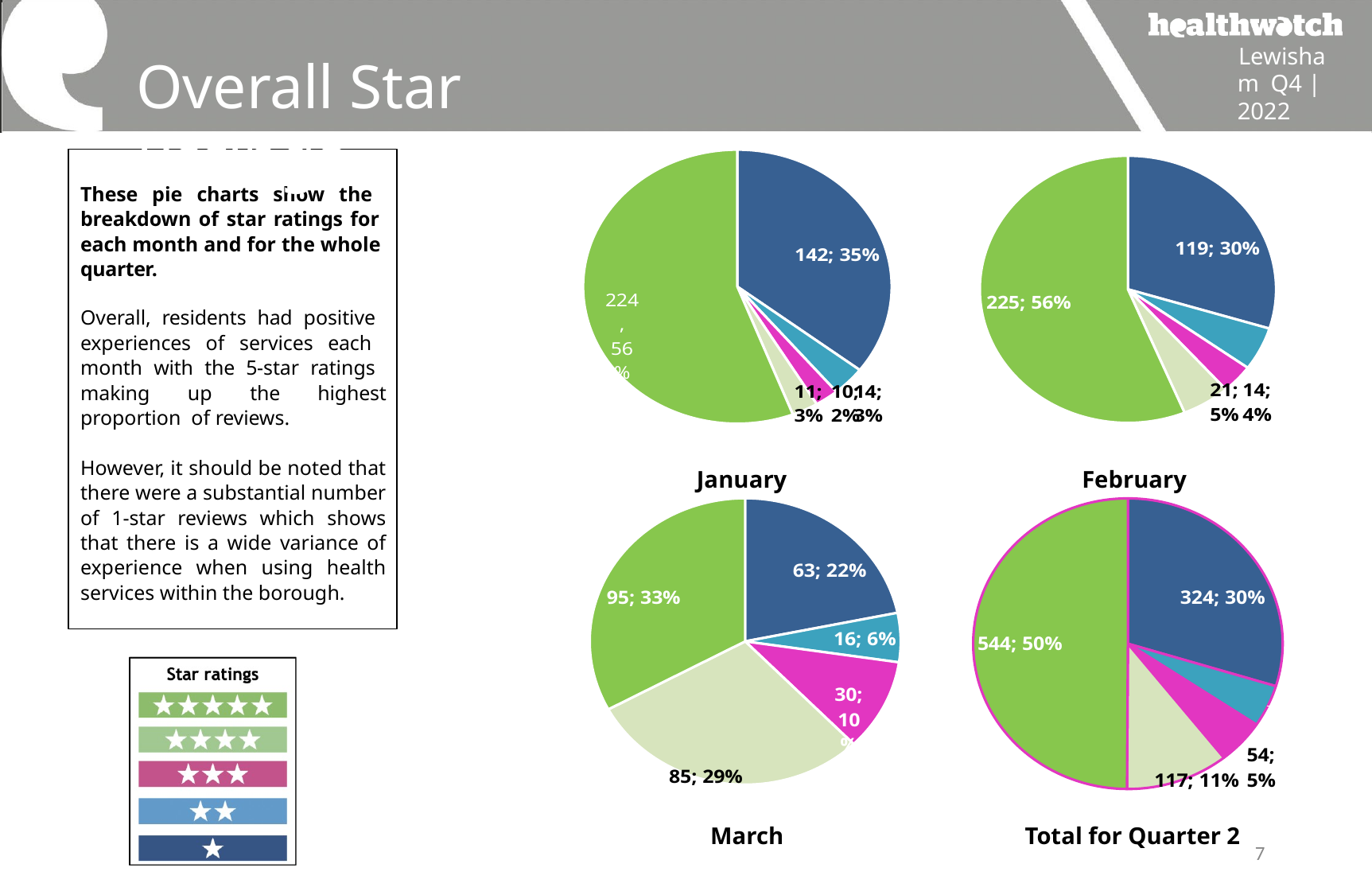
In the Total for Quarter 2 pie chart, what is the value and share of the green (5-star) slice? 544; 50% In the March pie chart, what is the difference in count between the 5-star slice (95) and the 4-star slice (85)? 10 In the March pie chart, which slice is the largest? 95; 33% (5-star) In the January pie chart, what is the value and share of the largest slice? 224; 56% In the January pie chart, what is the value and share of the dark blue (1-star) slice? 142; 35% In the Total for Quarter 2 pie chart, which is larger: the 1-star slice (324) or the 4-star slice (117)? 1-star slice (324) In the March pie chart, what is the value and share of the pink (3-star) slice? 30; 10% In the February pie chart, what is the value and share of the dark blue (1-star) slice? 119; 30% How many star-rating categories does the legend list? 5 How many pie charts are on the slide? 4 What kind of charts are shown on the slide? Pie charts In the February pie chart, what is the value and share of the green (5-star) slice? 225; 56%